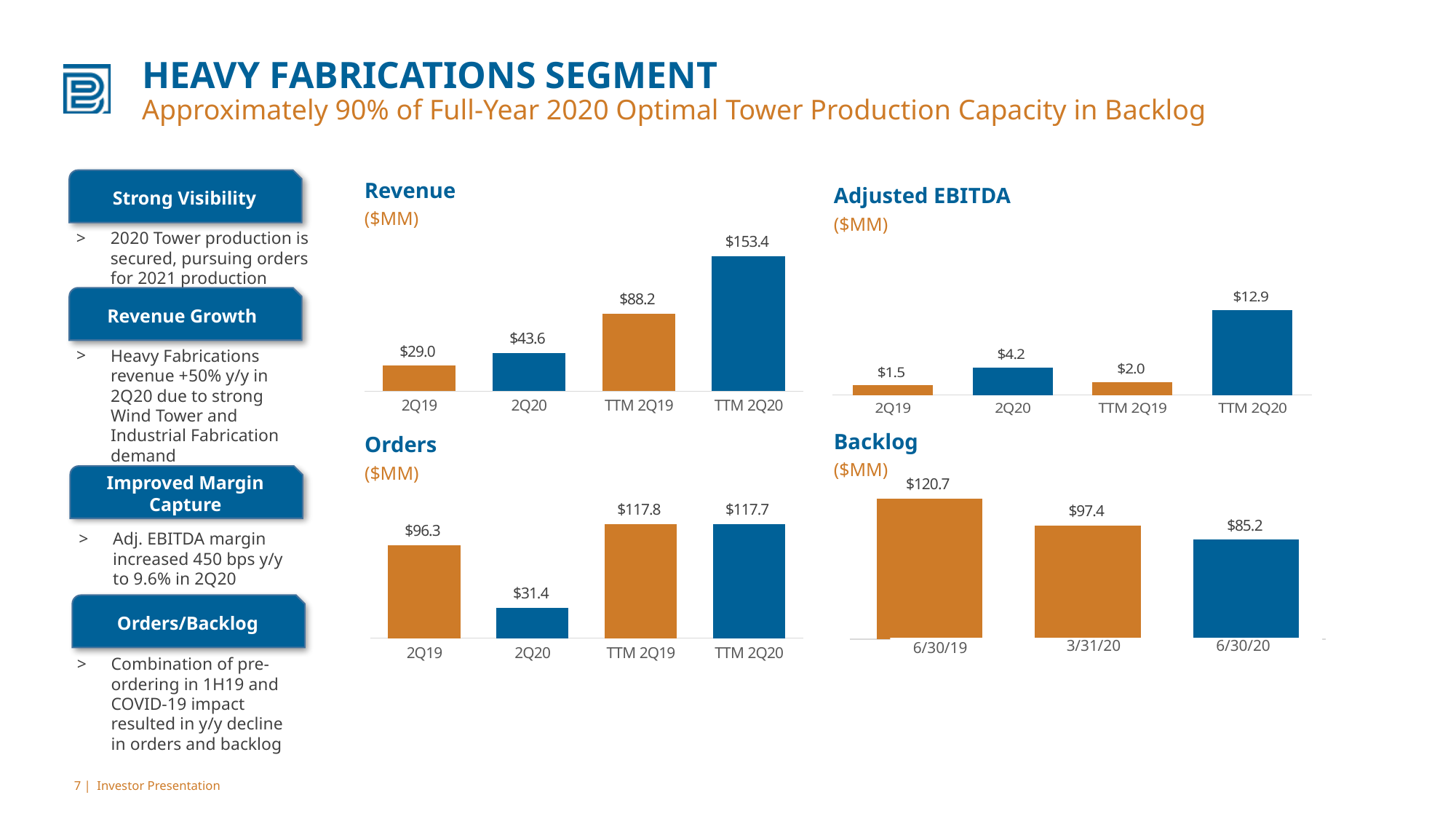
In the Orders chart, what is the difference between the 2Q19 and 2Q20 values? $64.9 What unit is shown under the Adjusted EBITDA chart title? ($MM) How many bars are in the Backlog chart? 3 In the Backlog chart, do the values rise or fall from 6/30/19 to 6/30/20? fall In the Revenue chart, what is the value for TTM 2Q20? $153.4 In the Revenue chart, what is the difference between the 2Q20 and 2Q19 values? $14.6 In the Backlog chart, what is the value for 3/31/20? $97.4 What kind of chart is the Revenue chart? bar chart In the Revenue chart, what is the value for 2Q19? $29.0 In the Adjusted EBITDA chart, which category has the lowest value? 2Q19 In the Orders chart, which is larger, TTM 2Q19 or TTM 2Q20? TTM 2Q19 In the Adjusted EBITDA chart, which category has the highest value? TTM 2Q20